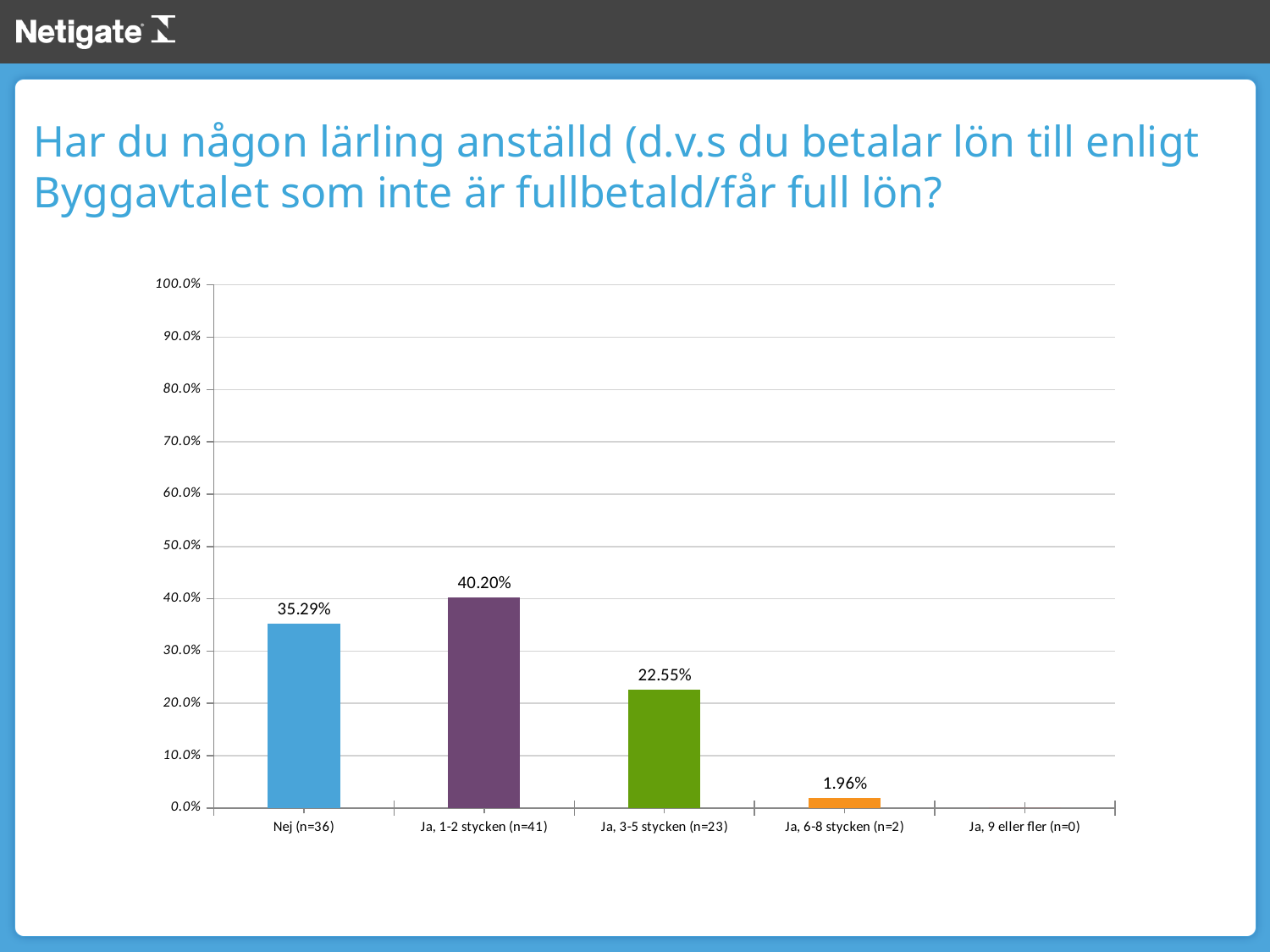
Which category with a visible bar has the lowest value? Ja, 6-8 stycken (n=2) How many categories are shown on the x axis? 5 What is the difference between the values for "Ja, 1-2 stycken (n=41)" and "Nej (n=36)"? 4.91% What kind of chart is shown on the slide? bar chart Which category has the highest value? Ja, 1-2 stycken (n=41) What is the value for "Ja, 6-8 stycken (n=2)"? 1.96% Is the value for "Ja, 3-5 stycken (n=23)" greater or less than 30.0%? less What is the value for "Nej (n=36)"? 35.29% What is the highest value shown on the y axis? 100.0% Which is larger, the value for "Nej (n=36)" or the value for "Ja, 3-5 stycken (n=23)"? Nej (n=36) What is the value for "Ja, 3-5 stycken (n=23)"? 22.55% What is the value for "Ja, 1-2 stycken (n=41)"? 40.20%